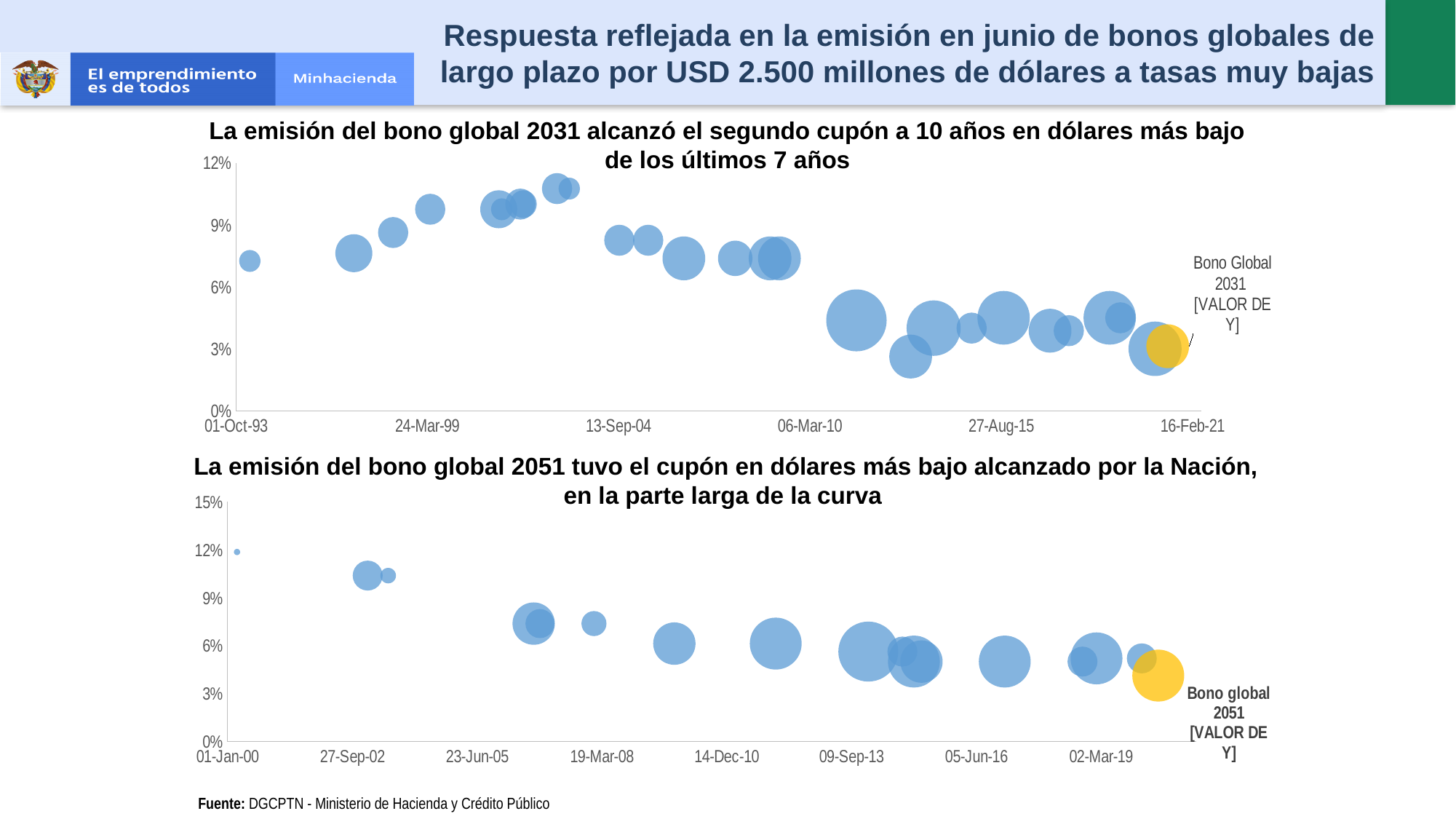
In the top chart, are the highest bubbles (around 2002-2003) greater or less than 9%? greater What kind of chart is the top chart on the slide? Bubble chart How many date labels are shown on the x axis of the bottom chart? 8 In the bottom chart, are the bubbles near 27-Sep-02 greater or less than 9%? greater What is the last date label on the x axis of the top chart? 16-Feb-21 What is the maximum value shown on the y axis of the bottom chart? 15% In the top chart (bono global 2031), do the coupon values overall rise or fall from left to right along the x axis? Fall In the top chart, is the value of the first bubble at 01-Oct-93 greater or less than 6%? greater What kind of chart is the bottom chart on the slide? Bubble chart In the bottom chart (bono global 2051), do the coupon values overall rise or fall from left to right along the x axis? Fall